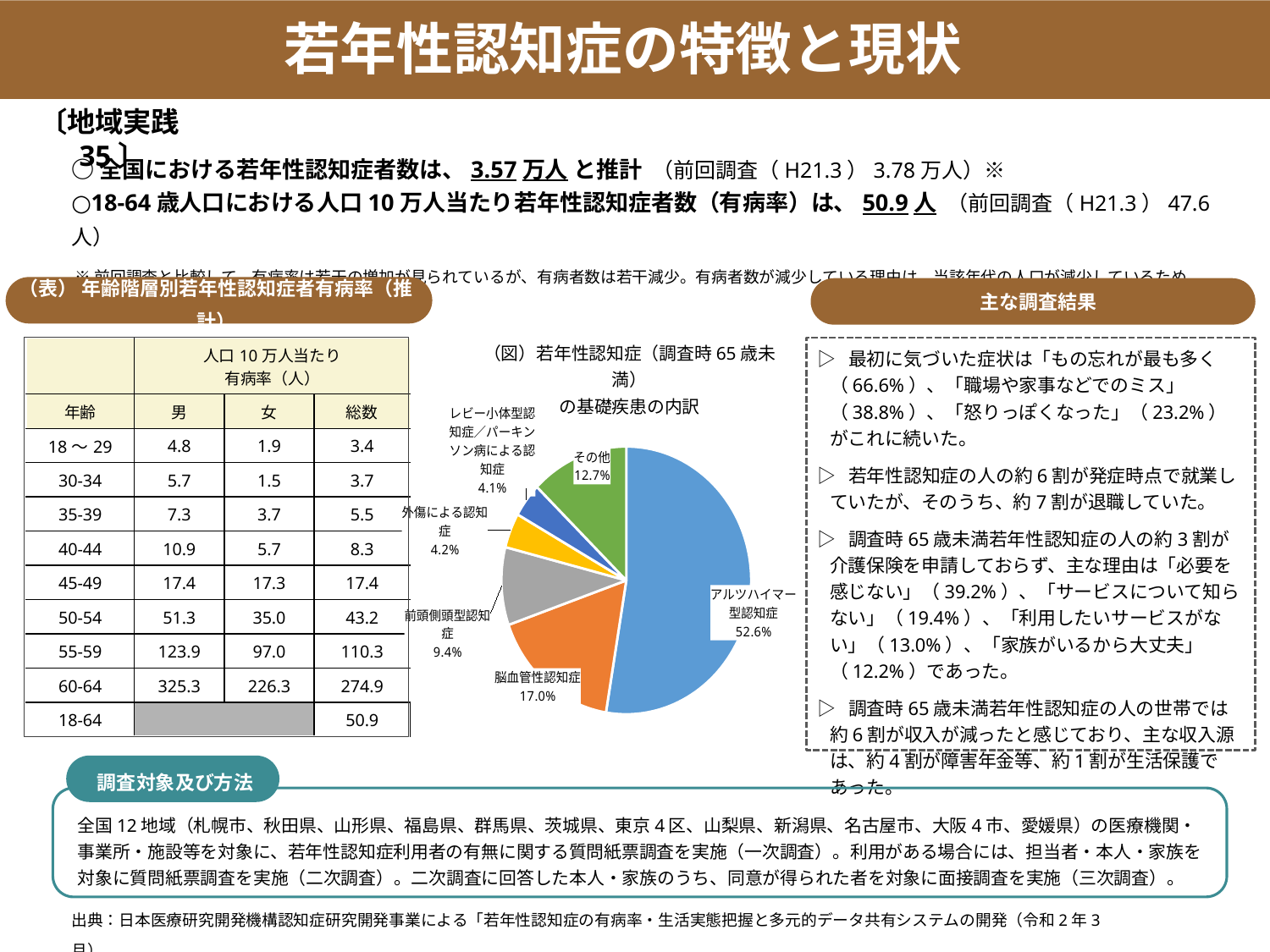
円グラフで、アルツハイマー型認知症と脳血管性認知症の割合の差は何ポイントですか？ 35.6ポイント 円グラフで、最も割合が大きい基礎疾患はどれですか？ アルツハイマー型認知症 円グラフで、「その他」の割合はいくらですか？ 12.7% 円グラフで、最も割合が小さい区分はどれですか？ レビー小体型認知症／パーキンソン病による認知症 円グラフで、外傷による認知症の割合はいくらですか？ 4.2% 円グラフで、脳血管性認知症の割合はいくらですか？ 17.0% 円グラフで、脳血管性認知症と「その他」ではどちらの割合が大きいですか？ 脳血管性認知症 円グラフで、前頭側頭型認知症の割合はいくらですか？ 9.4% 円グラフ「若年性認知症（調査時65歳未満）の基礎疾患の内訳」で、アルツハイマー型認知症の割合はいくらですか？ 52.6% 円グラフで、レビー小体型認知症／パーキンソン病による認知症の割合はいくらですか？ 4.1% スライドの図はどの種類のグラフですか？ 円グラフ 円グラフには区分がいくつありますか？ 6